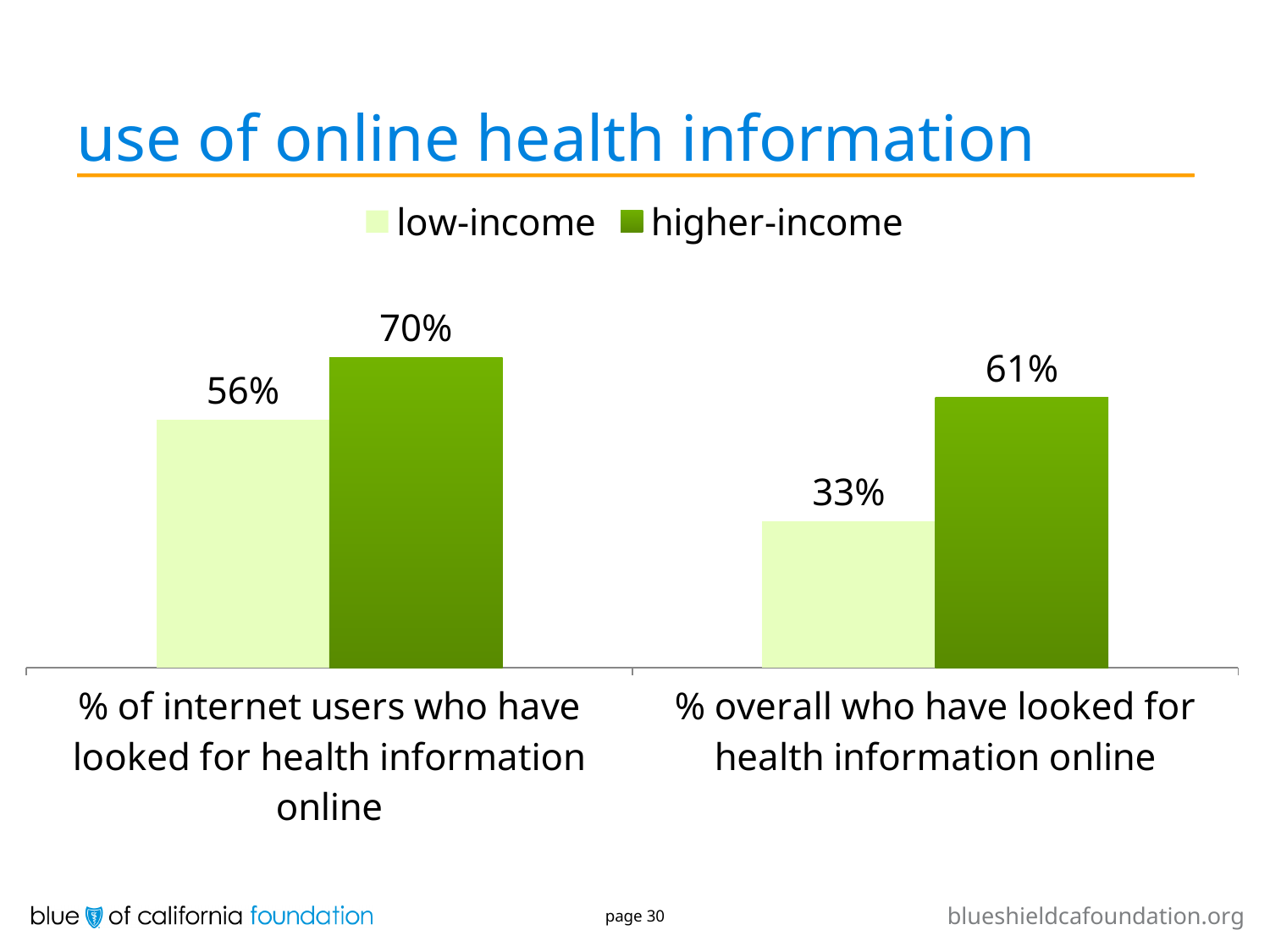
Which series has the higher value among internet users who have looked for health information online? higher-income What is the difference between the higher-income and low-income values for '% of internet users who have looked for health information online'? 14% How many series does the legend list? 2 What is the difference between the higher-income and low-income values for '% overall who have looked for health information online'? 28% What is the value for higher-income in the '% overall who have looked for health information online' category? 61% What is the value for low-income in the '% overall who have looked for health information online' category? 33% Which bar on the chart has the lowest value? low-income, % overall who have looked for health information online What percentage of higher-income internet users have looked for health information online? 70% What type of chart is shown on the slide? bar chart Which bar on the chart has the highest value? higher-income, % of internet users who have looked for health information online What percentage of low-income internet users have looked for health information online? 56% How many categories are shown on the x axis? 2